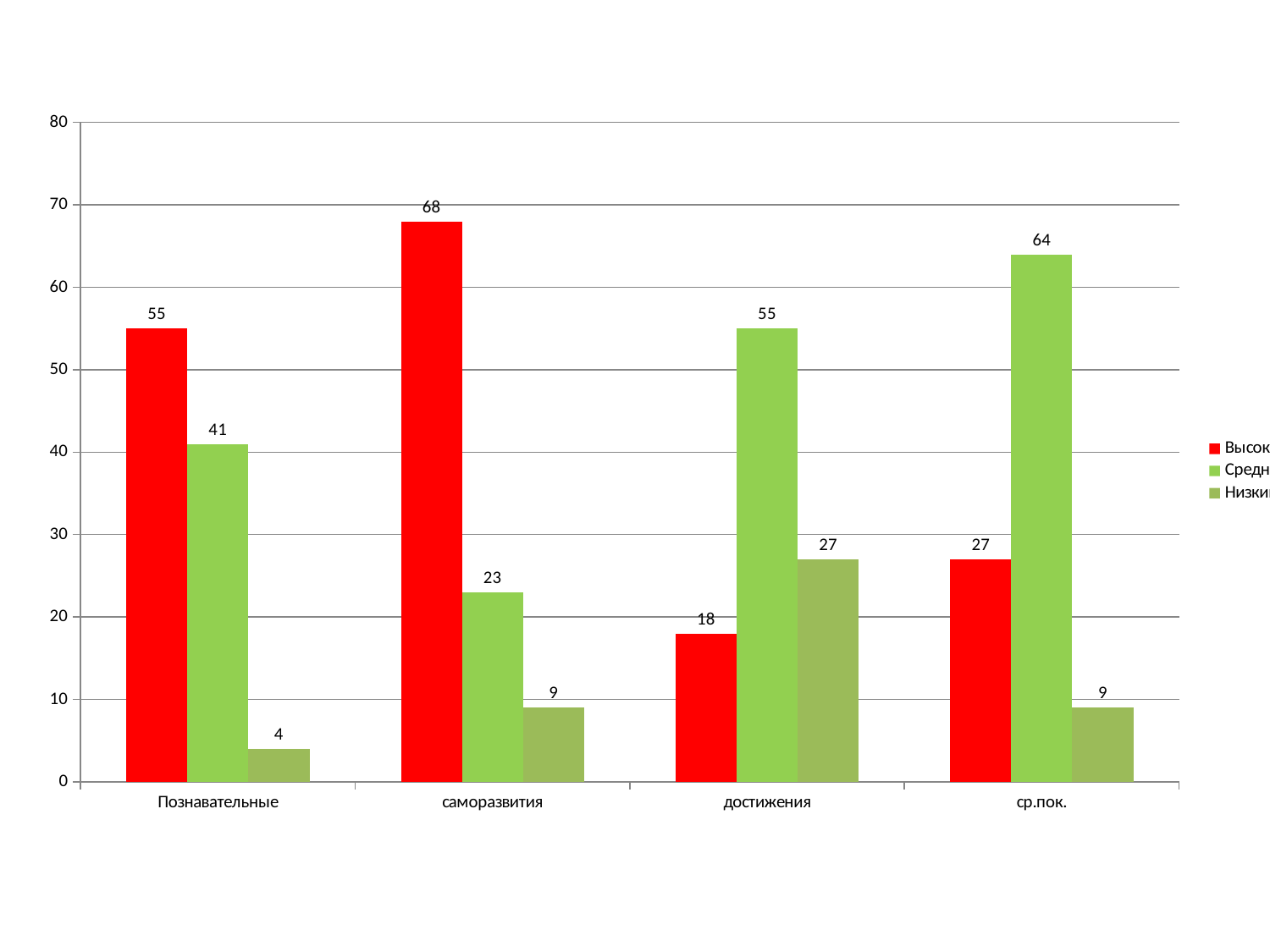
For достижения, which is larger: the red bar or the light green bar? the light green bar What is the difference between the red bar and the light green bar for саморазвития? 45 How many categories are shown on the x axis? 4 What is the value of the red bar for Познавательные? 55 What is the value of the red bar for саморазвития? 68 How many series does the legend list? 3 What is the total of the three bars for ср.пок.? 100 Which category has the highest red bar? саморазвития Which category has the lowest olive green bar? Познавательные What is the value of the light green bar for ср.пок.? 64 What kind of chart is shown on the slide? bar chart What is the value of the olive green bar for достижения? 27